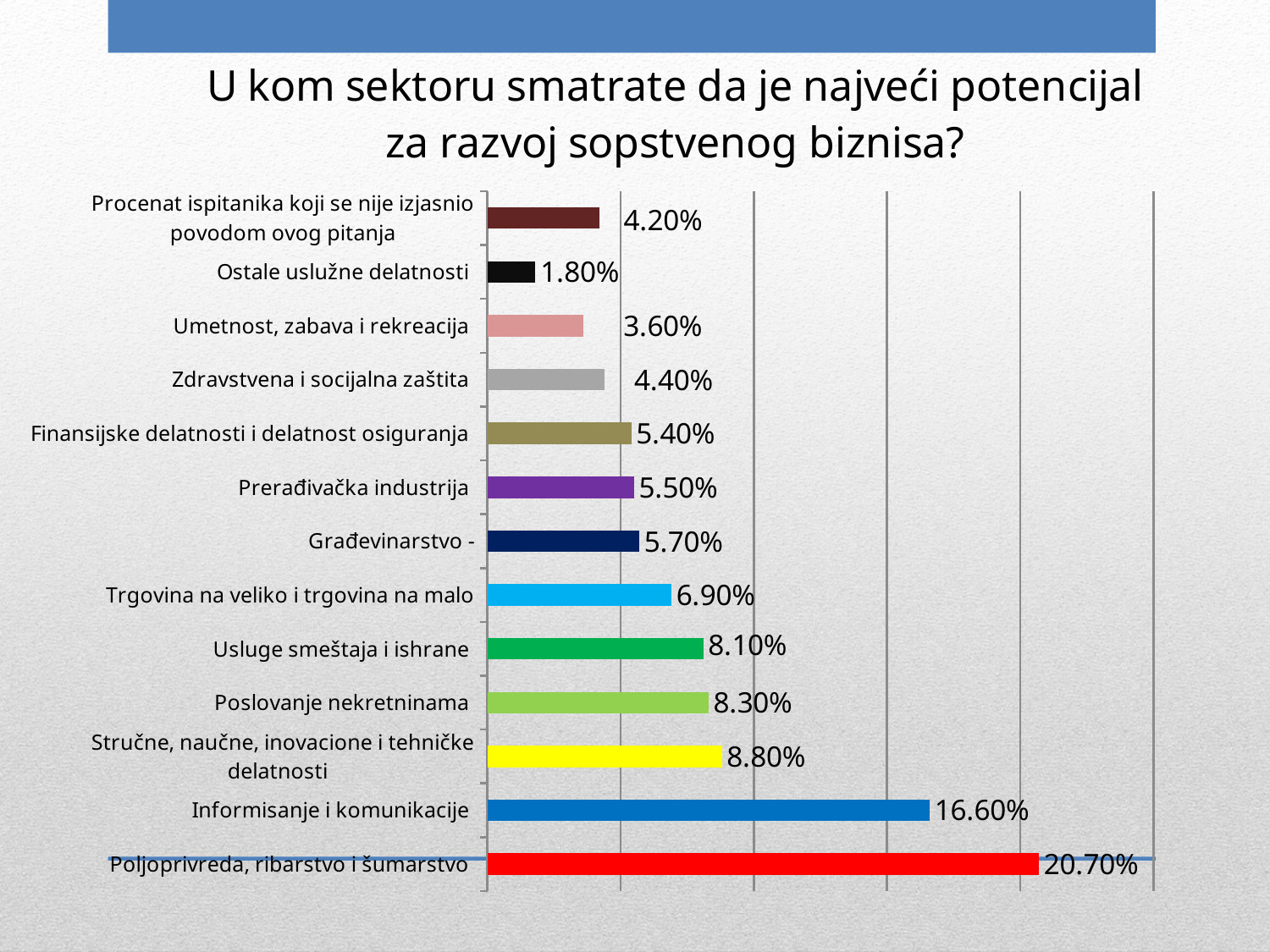
What is the difference between the values for Stručne, naučne, inovacione i tehničke delatnosti and Trgovina na veliko i trgovina na malo? 1.90% What is the value for Umetnost, zabava i rekreacija? 3.60% Which is larger, the value for Poslovanje nekretninama or the value for Građevinarstvo? Poslovanje nekretninama Which category has the lowest value? Ostale uslužne delatnosti What is the value for Informisanje i komunikacije? 16.60% What is the difference between the values for Poljoprivreda, ribarstvo i šumarstvo and Informisanje i komunikacije? 4.10% What is the value for Usluge smeštaja i ishrane? 8.10% What is the title of the slide? U kom sektoru smatrate da je najveći potencijal za razvoj sopstvenog biznisa? What kind of chart is shown on the slide? Bar chart How many categories are shown in the chart? 13 Which category has the highest value? Poljoprivreda, ribarstvo i šumarstvo Which is larger, the value for Zdravstvena i socijalna zaštita or the value for Umetnost, zabava i rekreacija? Zdravstvena i socijalna zaštita